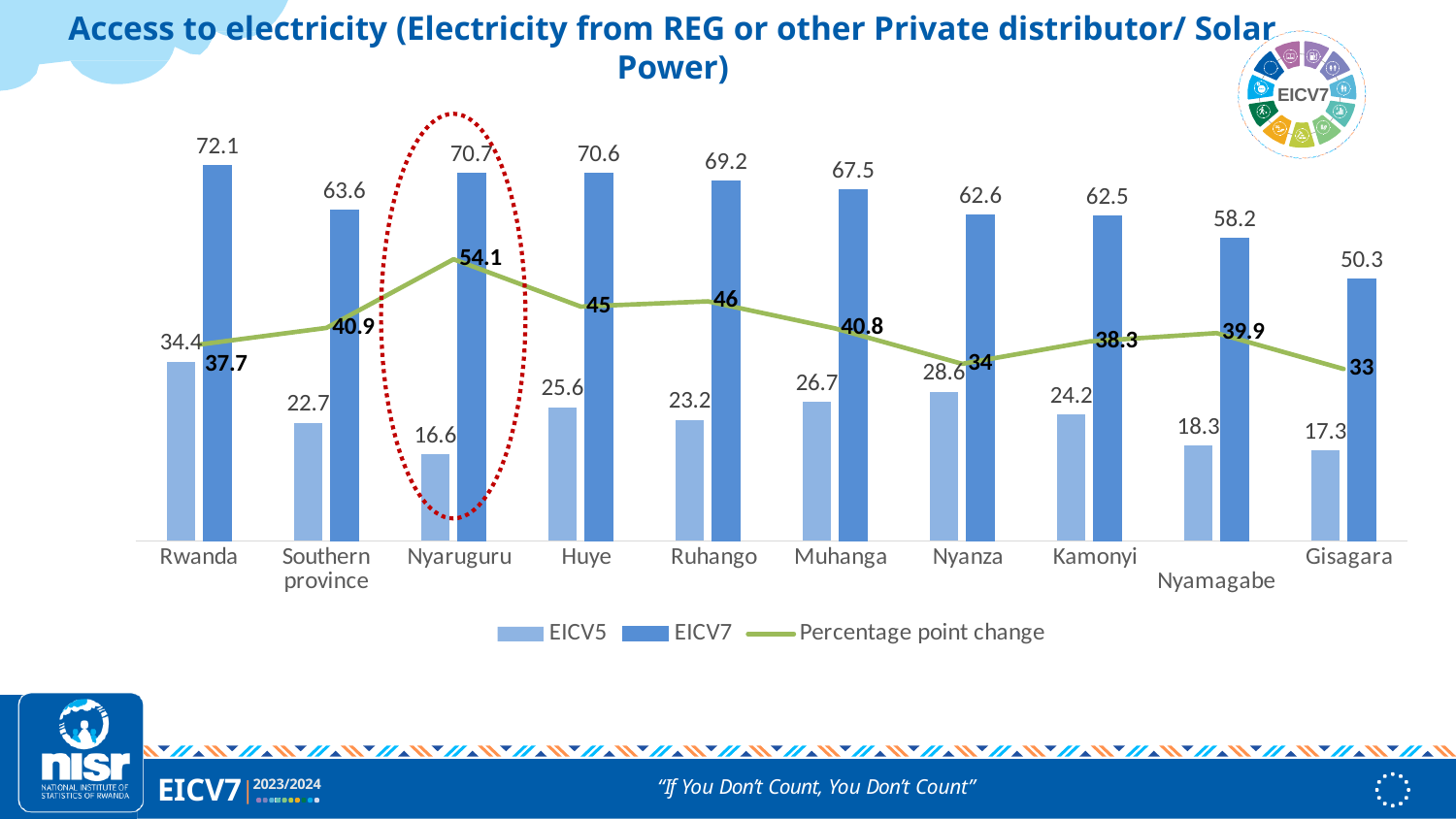
What is the percentage point change for Huye? 45 What is the EICV5 value for Rwanda? 34.4 How many categories are shown on the x axis? 10 Which category is highlighted with a red dotted circle? Nyaruguru Which has the larger EICV5 value, Nyanza or Muhanga? Nyanza What is the EICV7 value for Nyamagabe? 58.2 Which category has the lowest EICV5 value? Nyaruguru Which category has the highest percentage point change? Nyaruguru What is the difference between the EICV7 and EICV5 values for Rwanda? 37.7 What is the EICV7 value for Nyaruguru? 70.7 How many series does the legend list? 3 Which category has the lowest EICV7 value? Gisagara